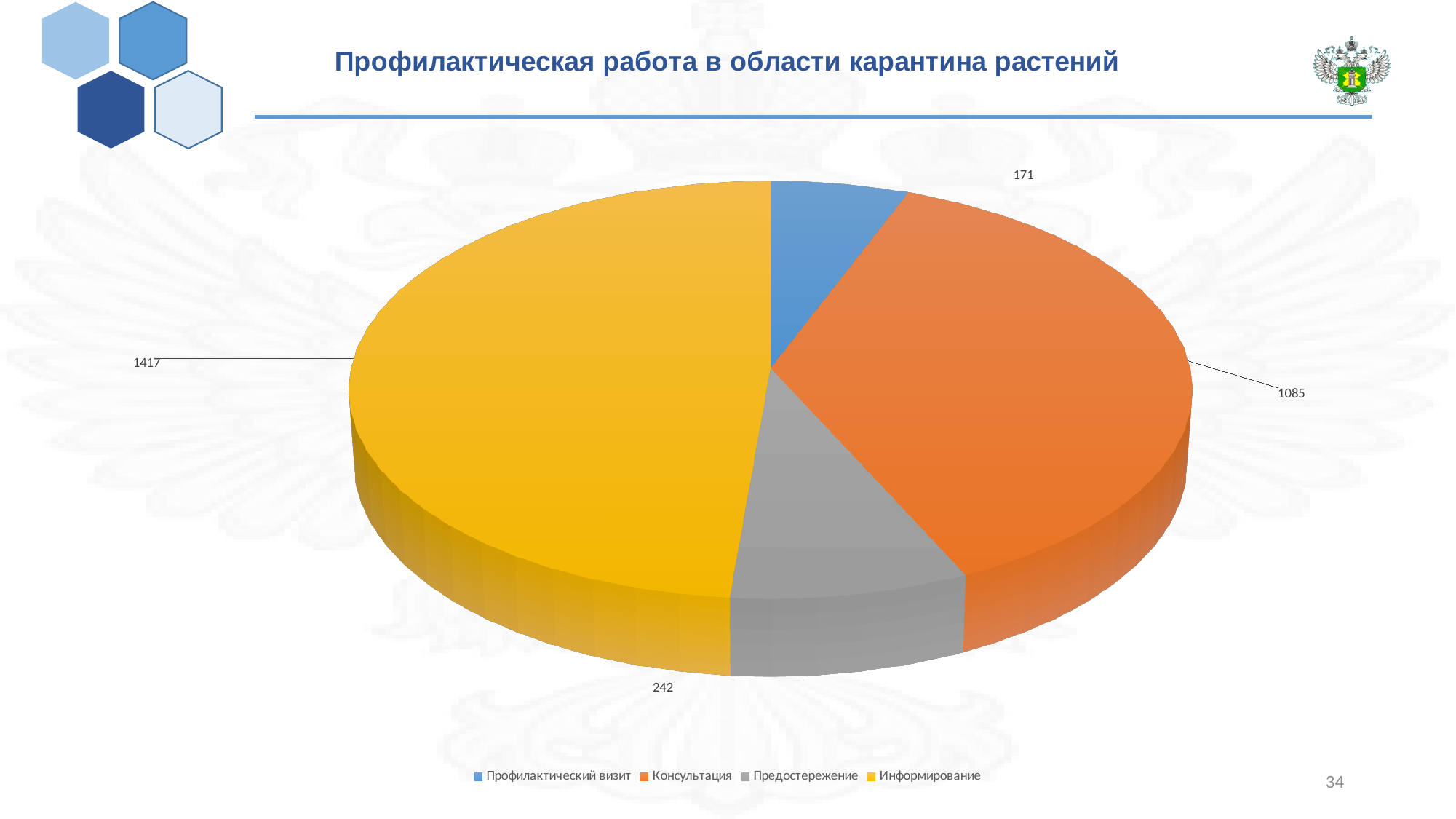
What is the value for Предостережение? 242 Which is larger, the value for Предостережение or the value for Профилактический визит? Предостережение How many slices does the pie chart have? 4 What kind of chart is shown on the slide? Pie chart What is the value for Информирование? 1417 What is the value for Консультация? 1085 Which category has the largest slice of the pie? Информирование What is the value for Профилактический визит? 171 Which category has the smallest slice of the pie? Профилактический визит What is the difference between the values for Информирование and Консультация? 332 What is the total of all four values in the pie chart? 2915 How many entries does the legend list? 4